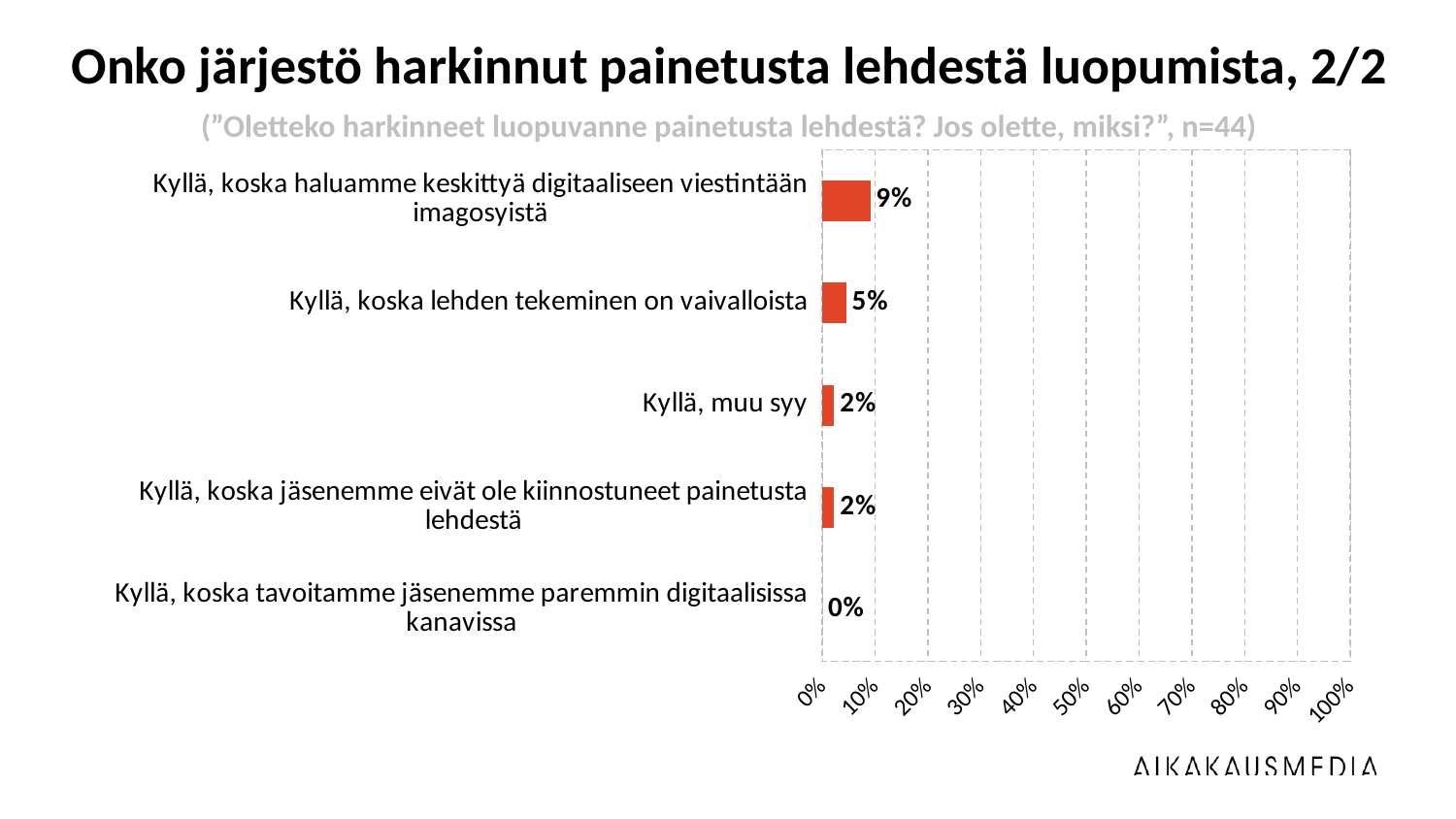
Which category has the highest value? Kyllä, koska haluamme keskittyä digitaaliseen viestintään imagosyistä What is the difference between the values for "Kyllä, koska haluamme keskittyä digitaaliseen viestintään imagosyistä" and "Kyllä, koska lehden tekeminen on vaivalloista"? 4% What kind of chart is shown on the slide? bar chart What is the value for "Kyllä, muu syy"? 2% What is the value for "Kyllä, koska tavoitamme jäsenemme paremmin digitaalisissa kanavissa"? 0% What is the value for "Kyllä, koska lehden tekeminen on vaivalloista"? 5% Which category has the lowest value? Kyllä, koska tavoitamme jäsenemme paremmin digitaalisissa kanavissa What is the value for "Kyllä, koska haluamme keskittyä digitaaliseen viestintään imagosyistä"? 9% How many categories are shown in the chart? 5 Is the value for "Kyllä, koska haluamme keskittyä digitaaliseen viestintään imagosyistä" greater or less than 10%? less Which is larger: the value for "Kyllä, koska lehden tekeminen on vaivalloista" or for "Kyllä, muu syy"? Kyllä, koska lehden tekeminen on vaivalloista What is the sample size (n) stated in the chart subtitle? n=44